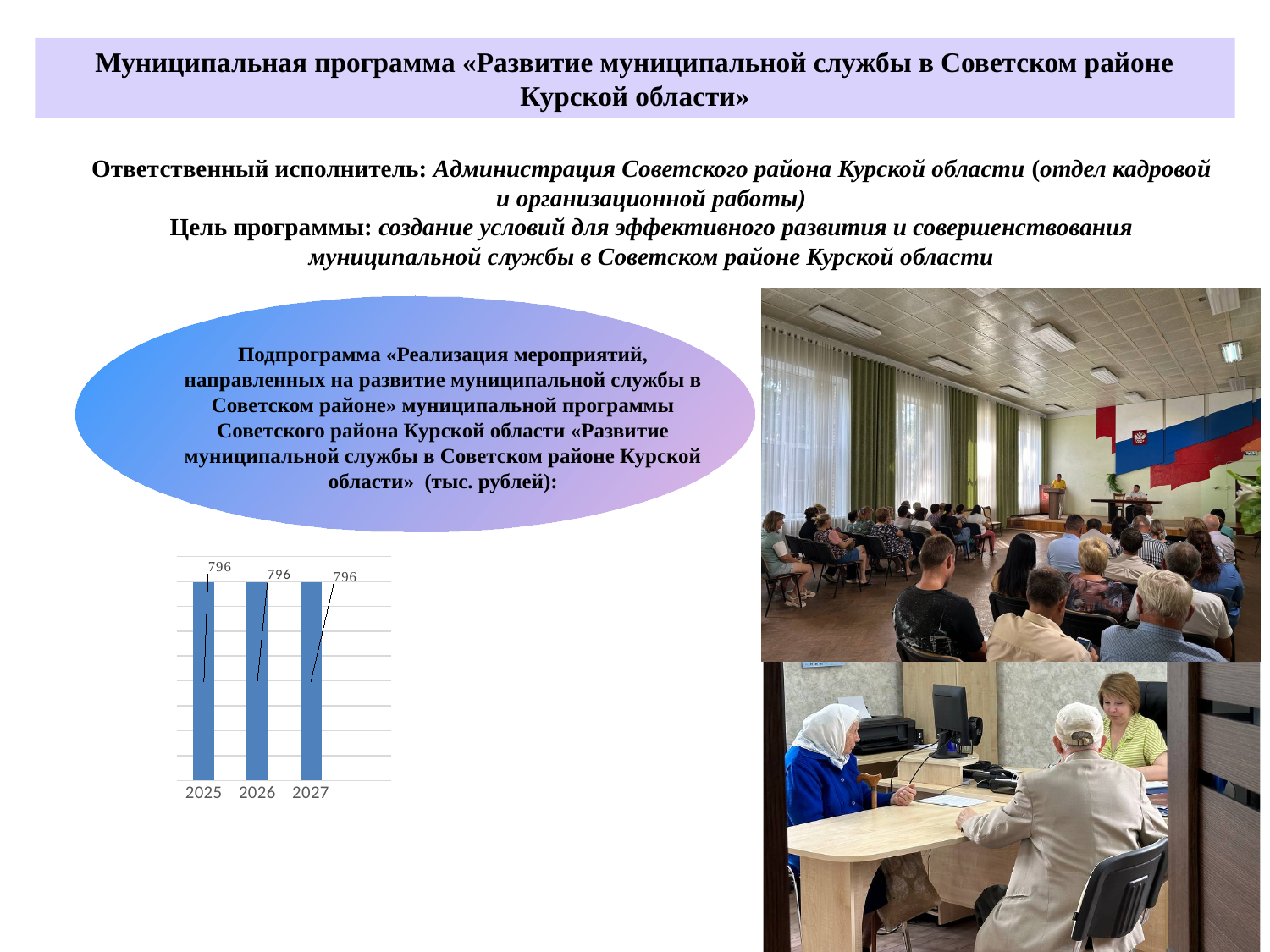
What is the difference between the values for 2025 and 2027 in the bar chart? 0 Do the values in the bar chart rise, fall or stay the same from 2025 to 2027? Stay the same How many years (categories) are shown in the bar chart? 3 Is the value for 2026 larger than, smaller than, or equal to the value for 2025 in the bar chart? Equal What is the value for 2027 in the bar chart? 796 Which year is the first category on the x axis of the bar chart? 2025 In what units are the values of the bar chart given, according to the text above it? тыс. рублей What is the value for 2026 in the bar chart? 796 What kind of chart is shown on the slide? Bar chart What is the value for 2025 in the bar chart? 796